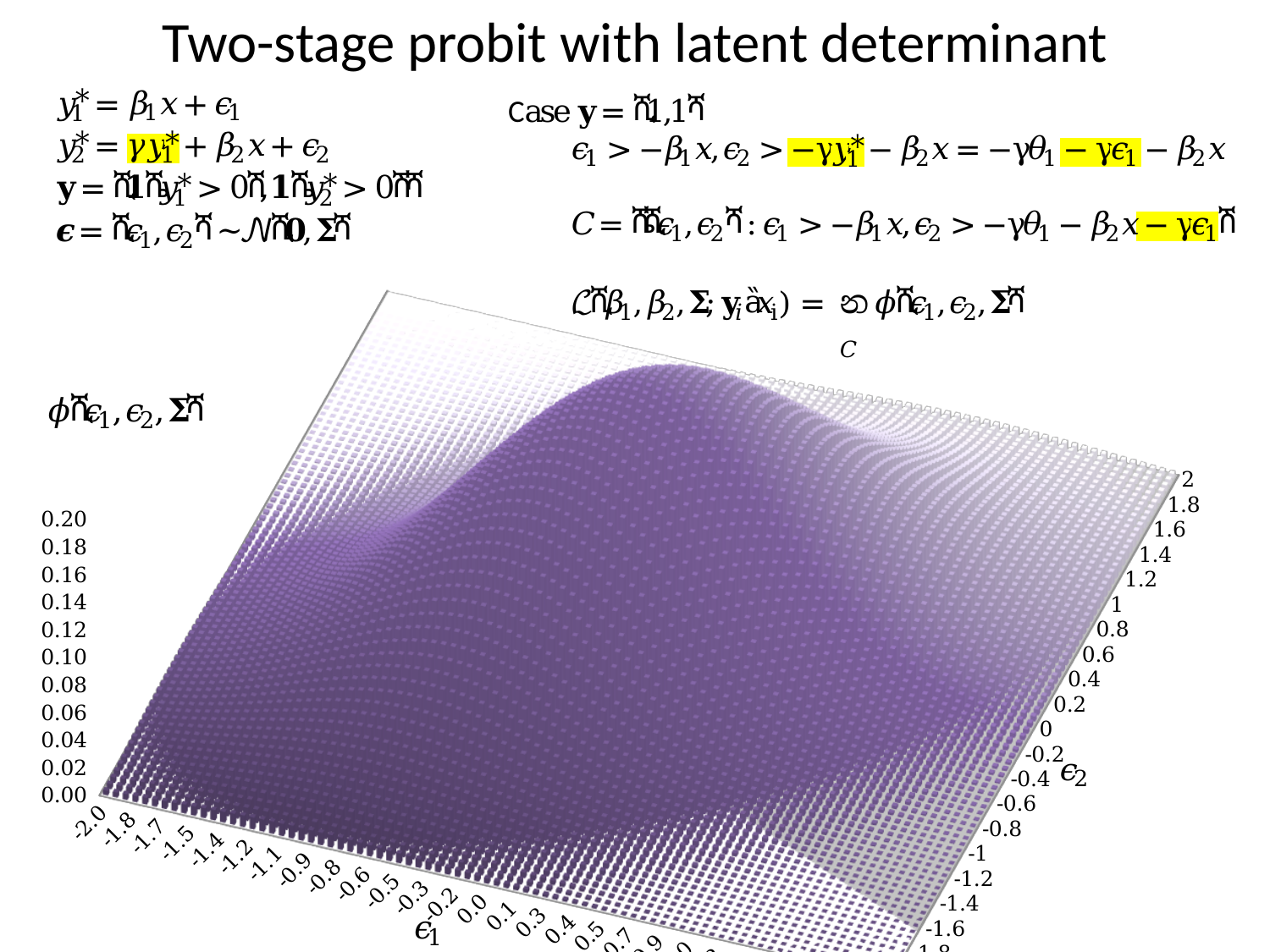
Which two variables are labelled on the horizontal axes of the surface chart? ε1 and ε2 What kind of chart is shown on the slide? 3D surface chart Is the peak of the plotted surface greater or less than 0.02 on the vertical axis? greater How many tick labels are shown on the vertical axis of the surface chart? 11 What is the highest tick value shown on the vertical axis of the surface chart? 0.20